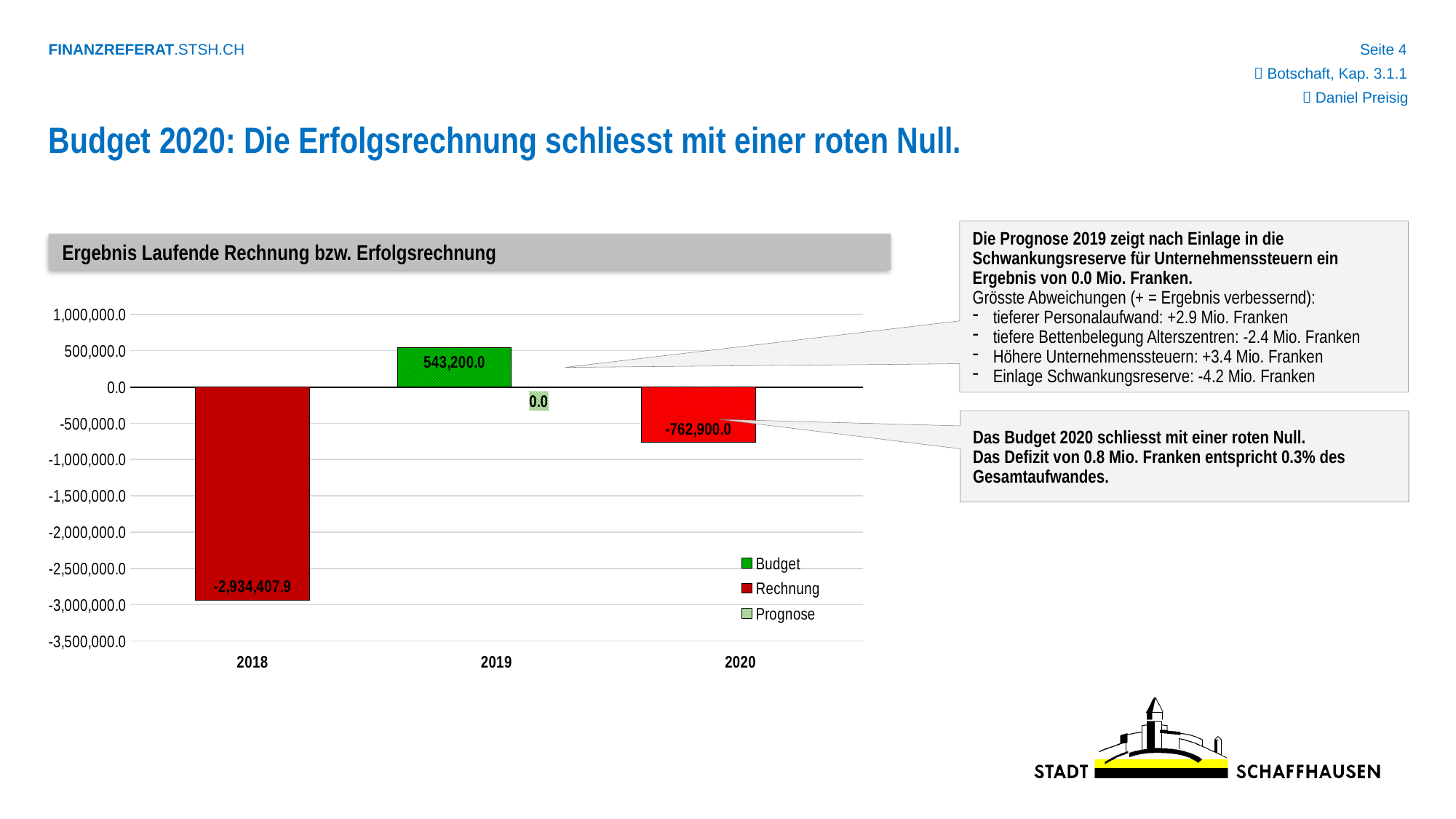
Which is larger, the value for 2018 or the value for 2020? 2020 Which year has the lowest value in the chart? 2018 Is the value for 2018 greater or less than -2,500,000.0? less What is the Prognose value shown for 2019? 0.0 What is the Budget value shown for 2019? 543,200.0 Which year has the highest value in the chart? 2019 What kind of chart is shown on the slide? bar chart How many years are shown on the x axis of the chart? 3 How many series does the chart legend list? 3 What is the value shown for 2018 in the chart? -2,934,407.9 What is the difference between the 2019 Budget value and the 2020 value? 1,306,100.0 What is the value shown for 2020 in the chart? -762,900.0